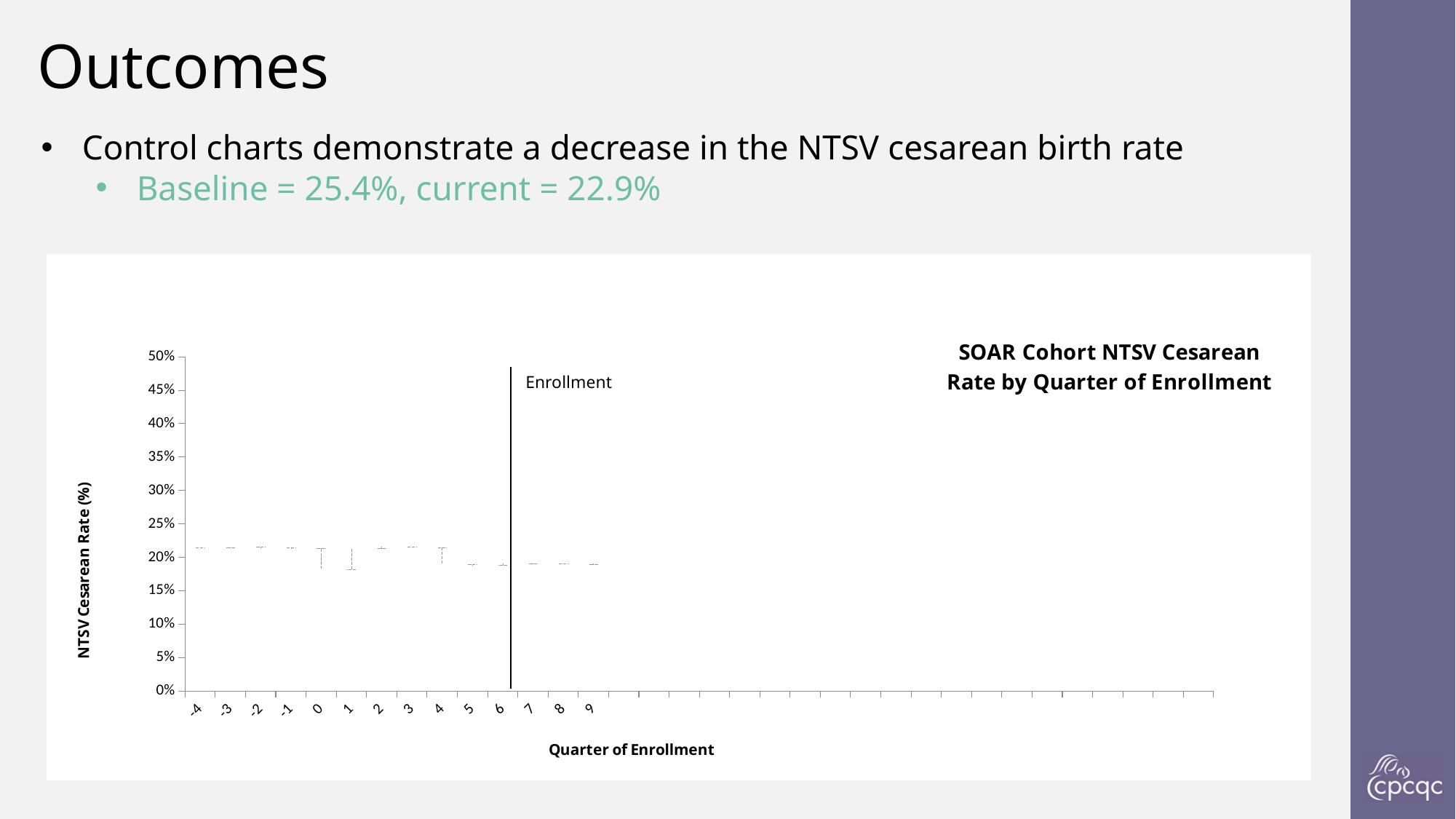
What label is given to the vertical line drawn on the chart? Enrollment Is the plotted value for quarter 0 greater or less than 5%? greater What is the title of the chart on the slide? SOAR Cohort NTSV Cesarean Rate by Quarter of Enrollment Is the plotted value for quarter 9 greater or less than 10%? greater Is the plotted value for quarter -4 greater or less than 30%? less How many quarter labels are shown along the x axis of the chart? 14